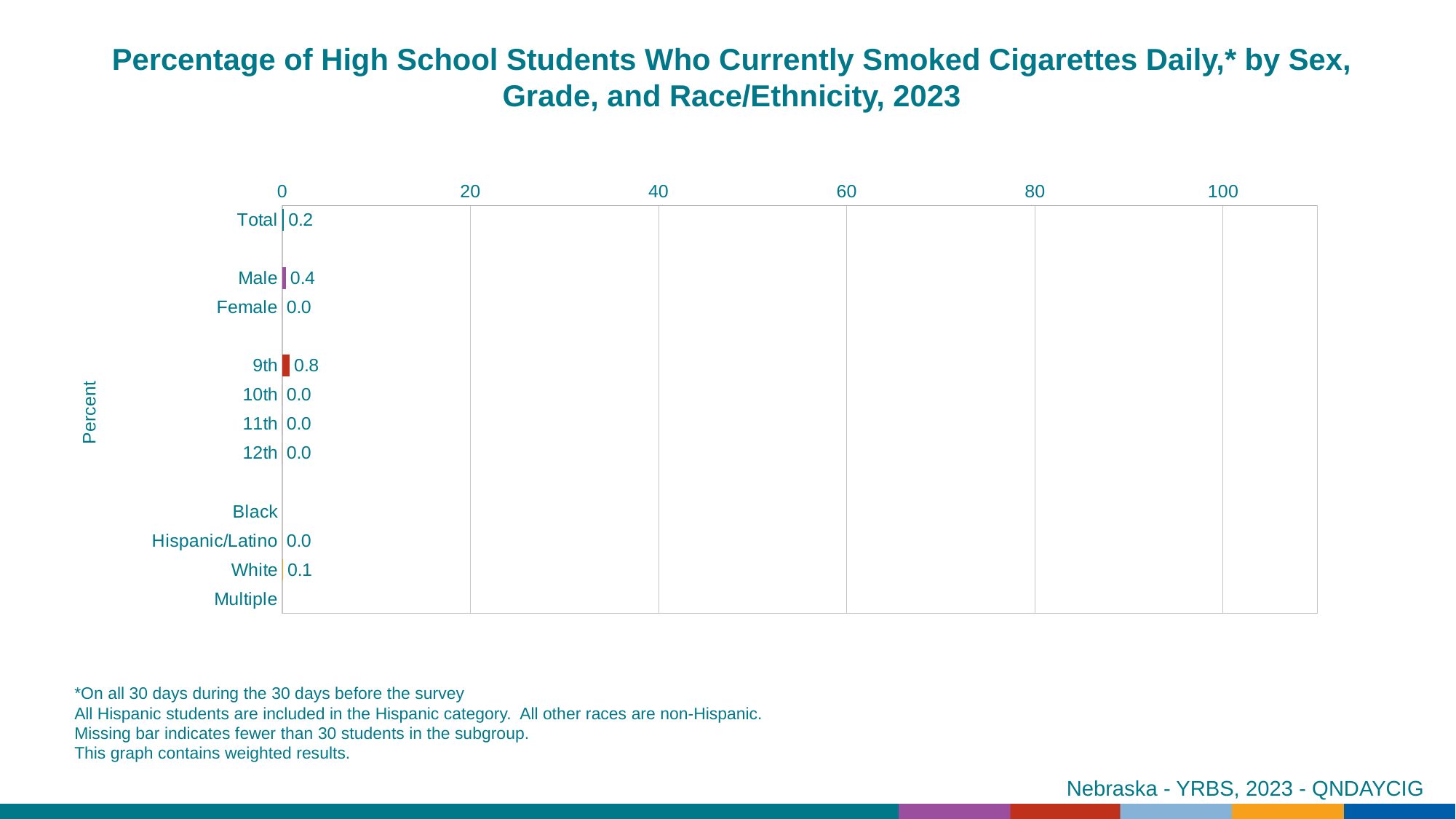
What is the value for White? 0.1 Which category has the highest value? 9th What is the value for Total? 0.2 What kind of chart is shown on the slide? bar chart Which categories have no bar and no data label shown? Black and Multiple What is the value for Female? 0.0 What is the value for 9th grade? 0.8 Which is larger, the value for Male or the value for Total? Male Is the value for 9th grade greater or less than 20? less What is the difference between the values for 9th grade and Male? 0.4 What is the value for Male? 0.4 How many categories are listed on the vertical axis? 12